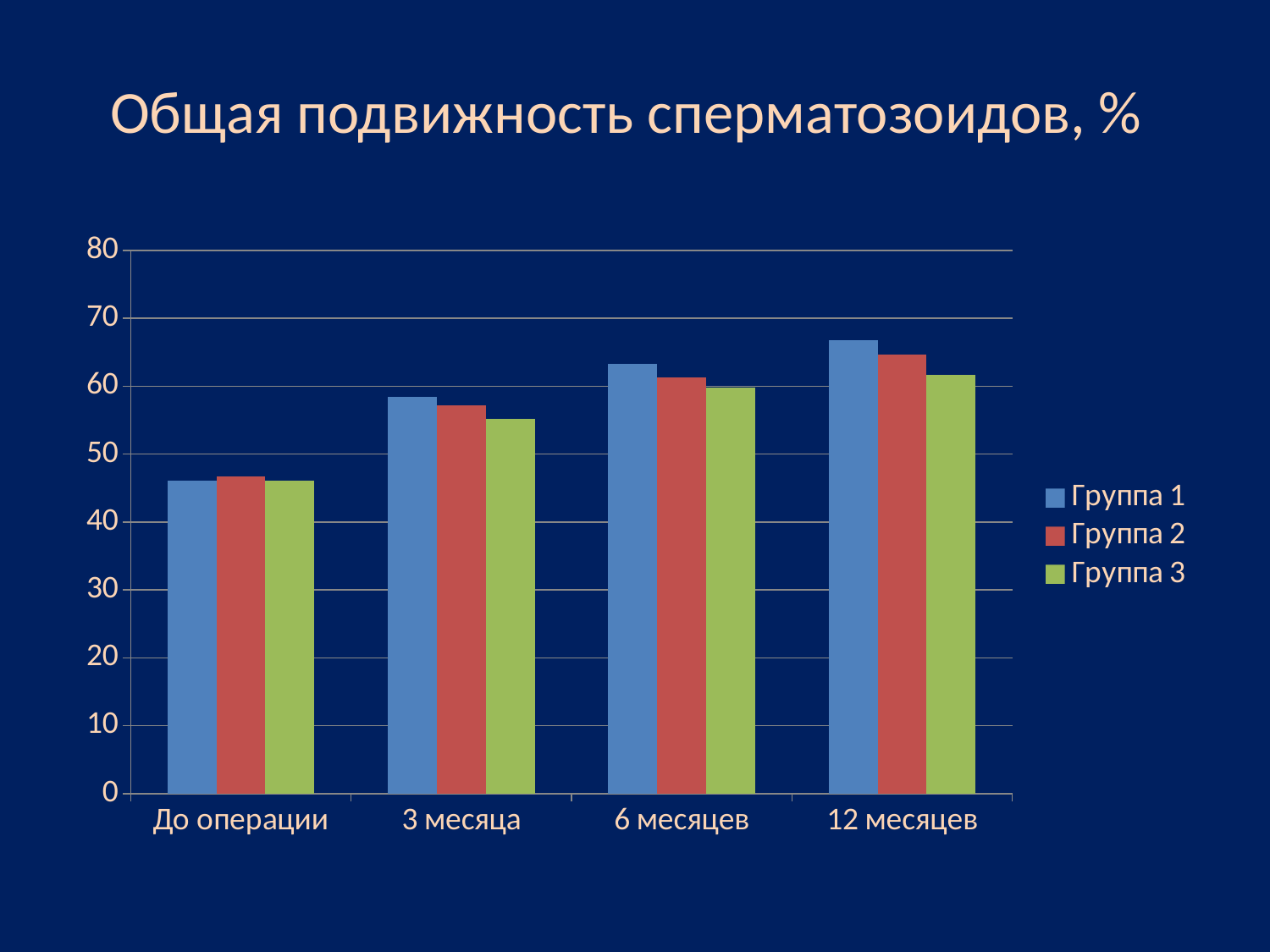
At which category does Группа 1 reach its highest value? 12 месяцев Is the value for Группа 1 at 12 месяцев greater or less than 60? greater Which series are listed in the legend? Группа 1, Группа 2, Группа 3 Is the value for Группа 3 at 3 месяца greater or less than 60? less What kind of chart is shown on the slide? bar chart How many series does the legend list? 3 Is the value for Группа 1 at 3 месяца greater or less than 50? greater At 12 месяцев, which is larger: the value for Группа 1 or for Группа 3? Группа 1 What is the title of the chart? Общая подвижность сперматозоидов, % At which category does Группа 3 have its lowest value? До операции How many categories are shown on the x axis? 4